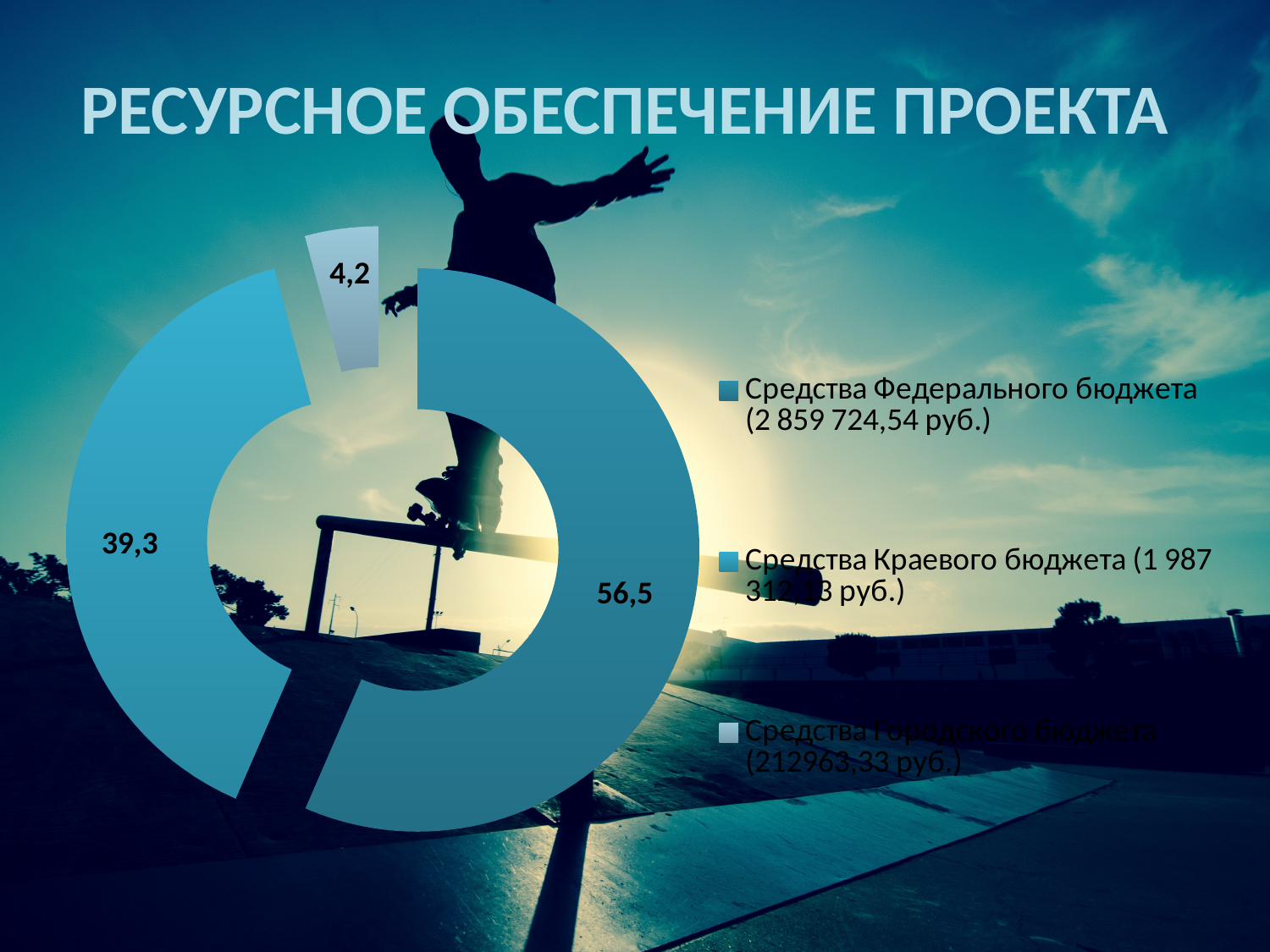
Which funding source has the largest slice? Средства Федерального бюджета What is the difference between the values for Средства Краевого бюджета and Средства Городского бюджета? 35,1 What kind of chart is shown on the slide? Doughnut (pie) chart What is the value shown for Средства Краевого бюджета? 39,3 What is the value shown for Средства Федерального бюджета? 56,5 What is the difference between the values for Средства Федерального бюджета and Средства Краевого бюджета? 17,2 Which funding source has the smallest slice? Средства Городского бюджета What is the title of the slide? РЕСУРСНОЕ ОБЕСПЕЧЕНИЕ ПРОЕКТА Which is larger: the slice for Средства Краевого бюджета or the slice for Средства Городского бюджета? Средства Краевого бюджета How many slices does the chart have? 3 What is the value shown for Средства Городского бюджета? 4,2 What amount in rubles does the legend give for Средства Федерального бюджета? 2 859 724,54 руб.